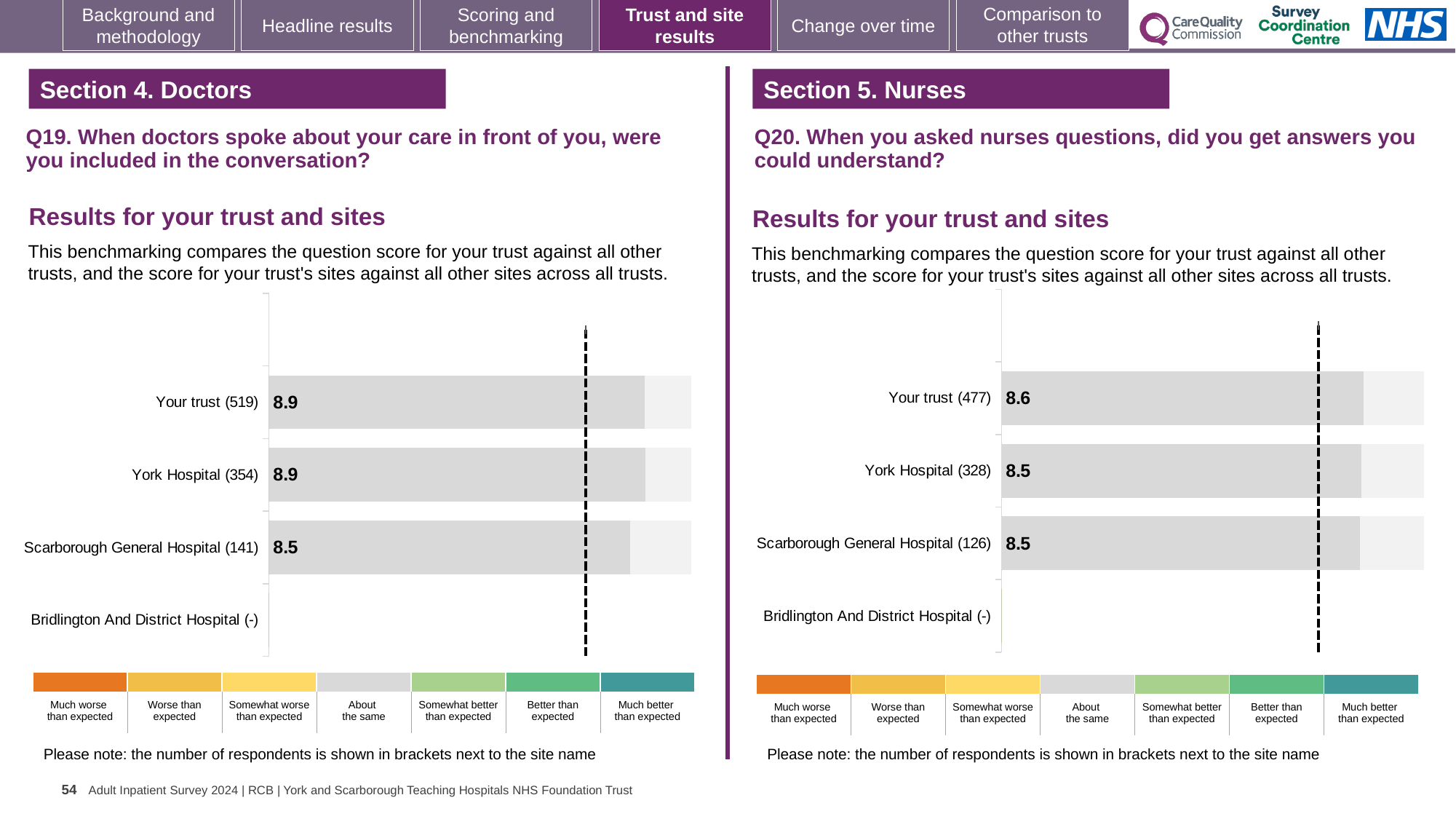
In the Q19 chart on the left, what is the score for Scarborough General Hospital? 8.5 In the Q20 chart on the right, which row has the highest score? Your trust In the Q19 chart on the left, what is the score for Your trust? 8.9 In the Q20 chart on the right, what is the score for York Hospital? 8.5 In the Q19 chart on the left, which site with a score shown has the lowest score? Scarborough General Hospital In the Q19 chart on the left, is the score for Your trust larger or smaller than the score for Scarborough General Hospital? larger What kind of chart is used in the Q19 chart on the left? bar chart In the Q20 chart on the right, what is the score for Your trust? 8.6 In the Q19 chart on the left, how many respondents are shown in brackets for York Hospital? 354 In the Q20 chart on the right, what is the difference between the score for Your trust and the score for Scarborough General Hospital? 0.1 How many rows (sites including Your trust) are listed in the Q20 chart on the right? 4 In the Q19 chart on the left, what is the difference between the score for York Hospital and the score for Scarborough General Hospital? 0.4